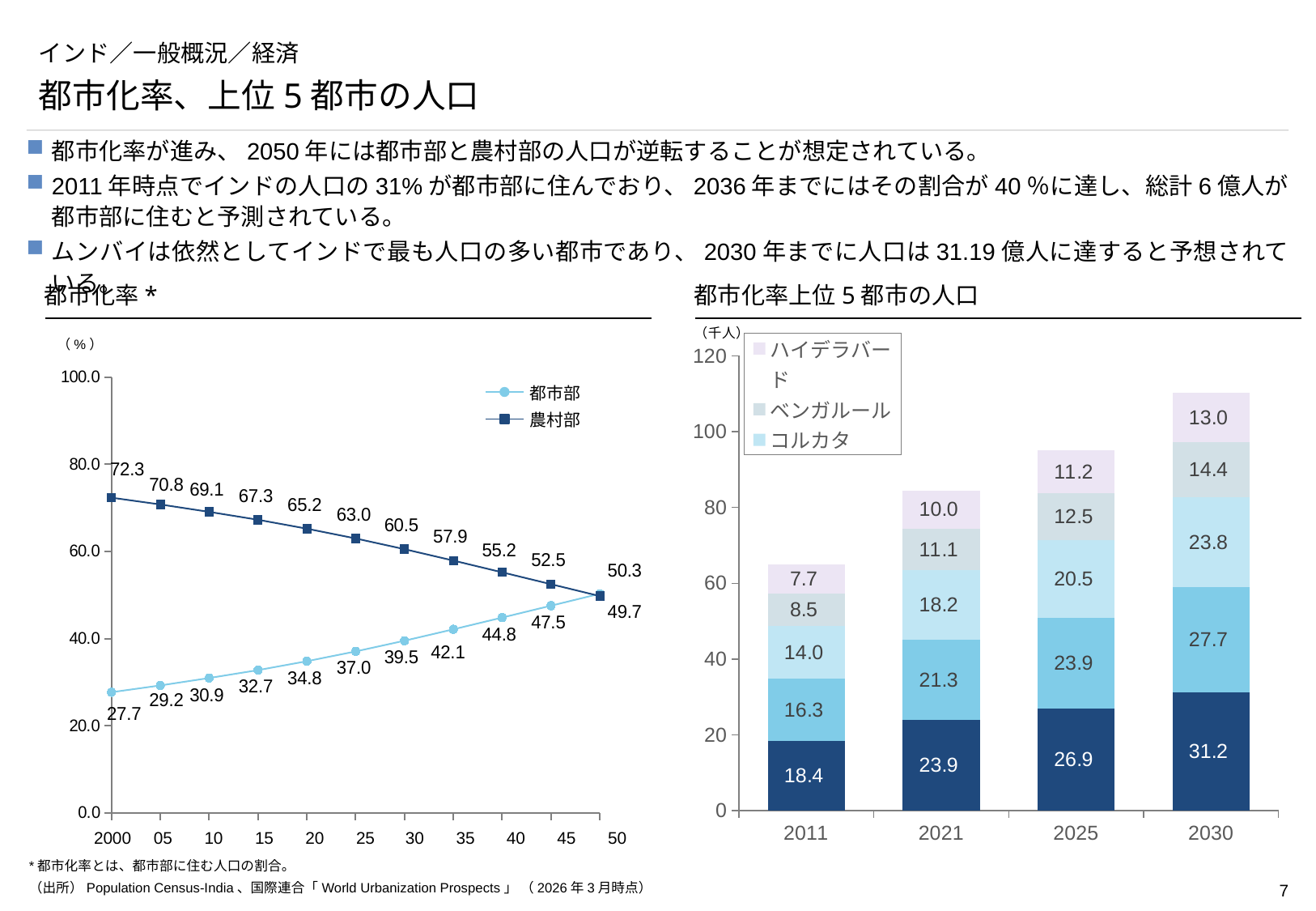
In the 都市化率上位5都市の人口 chart on the right, how many years are shown on the x axis? 4 In the 都市化率 chart on the left, what is the difference between 農村部 and 都市部 in 2000? 44.6 In the 都市化率上位5都市の人口 chart on the right, what is the value for コルカタ in 2011? 14.0 In the 都市化率上位5都市の人口 chart on the right, what is the total of the stacked bar for 2021? 84.5 In the 都市化率 chart on the left, does the 都市部 series rise or fall from 2000 to 2050? rise In the 都市化率 chart on the left, which series has the higher value in 2025, 都市部 or 農村部? 農村部 In the 都市化率 chart on the left, what is the value for 農村部 in 2050? 49.7 In the 都市化率上位5都市の人口 chart on the right, which year has the tallest stacked bar? 2030 In the 都市化率 chart on the left, what is the value for 都市部 in 2000? 27.7 What kind of chart is the 都市化率 chart on the left? line chart In the 都市化率 chart on the left, how many series does the legend list? 2 In the 都市化率上位5都市の人口 chart on the right, what is the value for ハイデラバード in 2030? 13.0